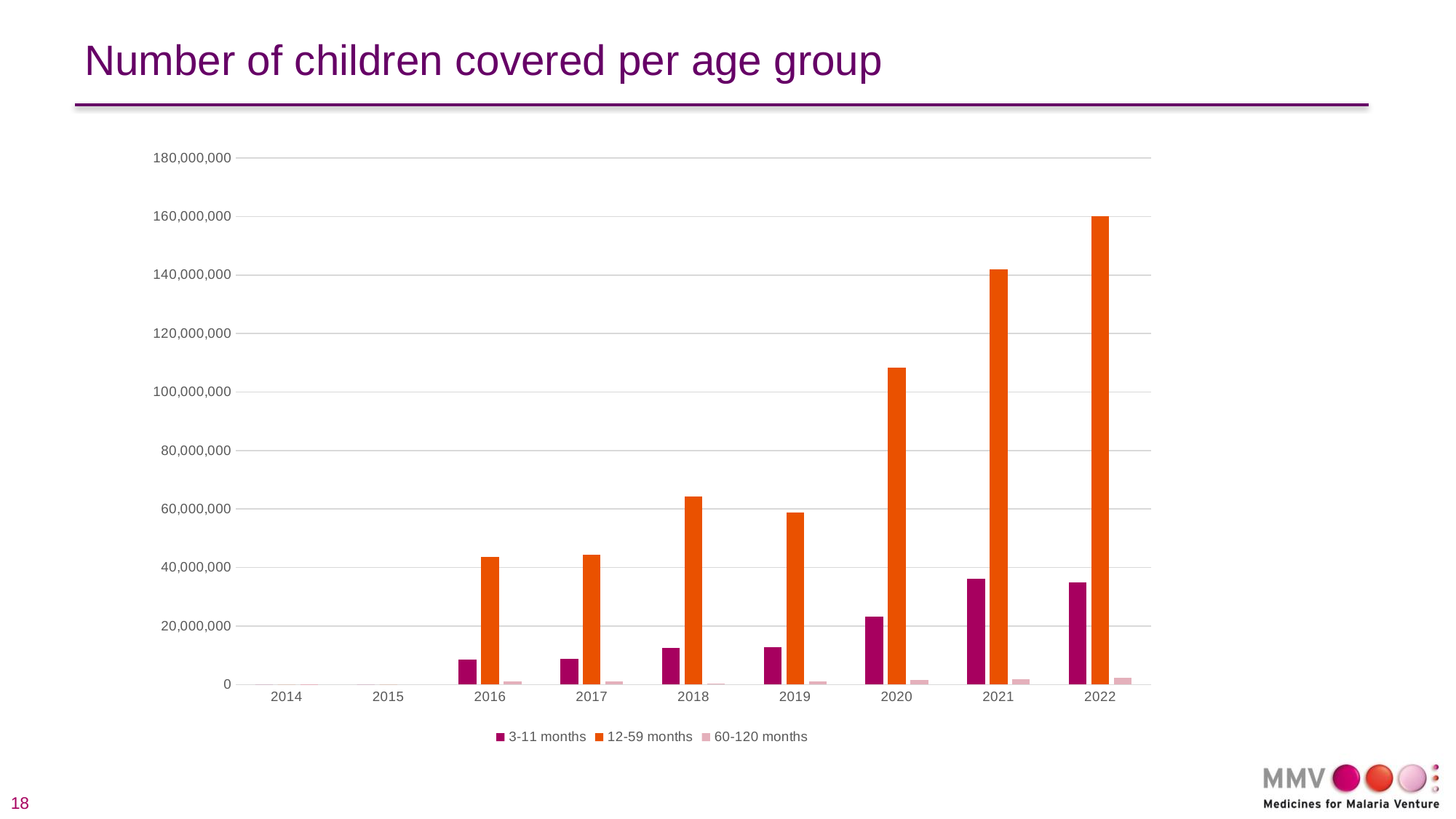
Is the value for 12-59 months in 2016 greater or less than 60,000,000? less How many years are shown on the x axis? 9 Which age group has the smallest value in 2022? 60-120 months Which is larger for 12-59 months: the value in 2020 or in 2021? 2021 Which is larger for 12-59 months: the value in 2018 or in 2019? 2018 How many series does the legend list? 3 What is the title of the chart? Number of children covered per age group Is the value for 3-11 months in 2021 greater or less than 20,000,000? greater What kind of chart is shown on the slide? bar chart In which year is the value for 12-59 months highest? 2022 Is the value for 12-59 months in 2020 greater or less than 100,000,000? greater